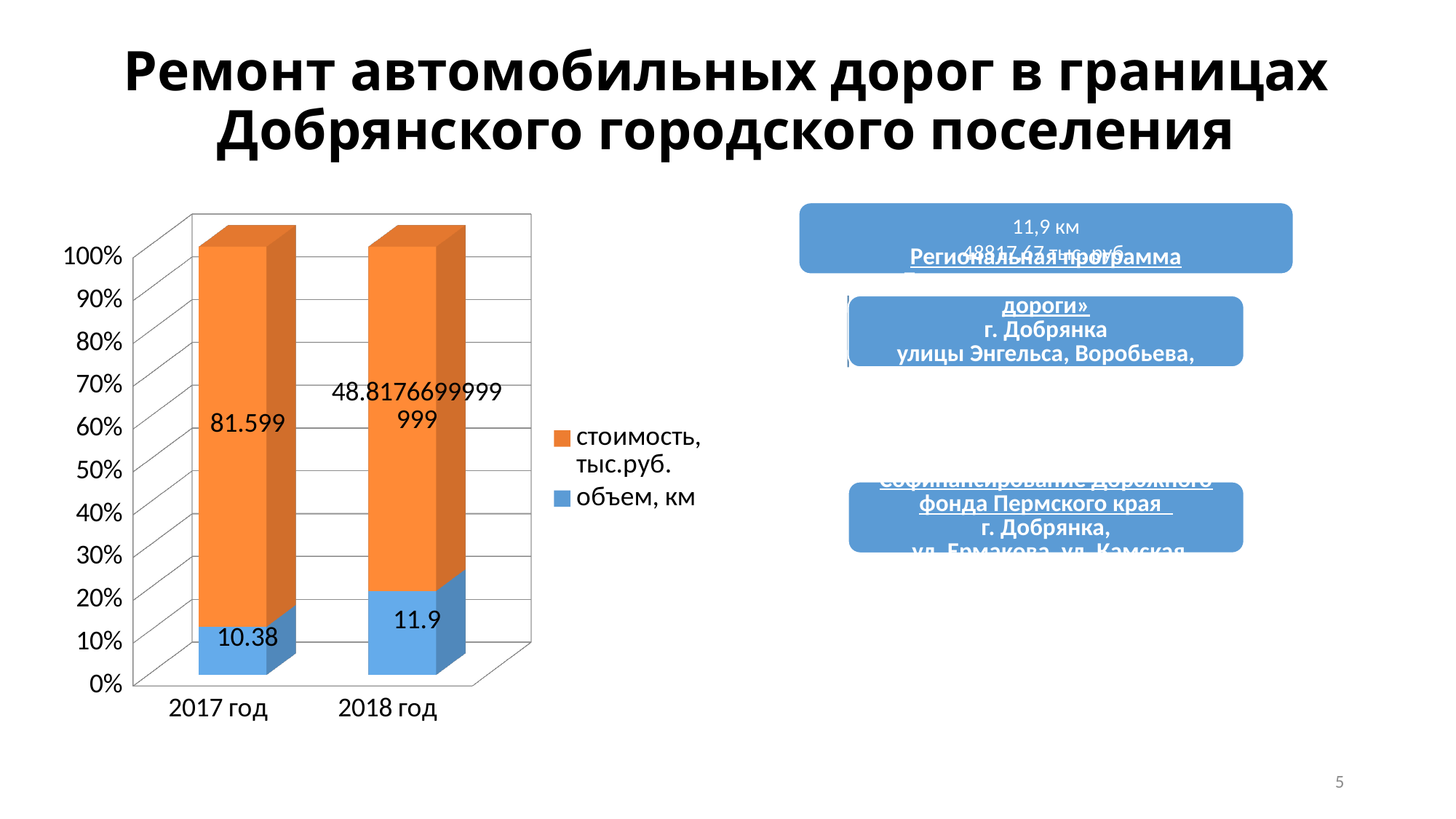
What kind of chart is shown on the slide? Stacked bar chart What is the value of объем, км for 2017 год? 10.38 Is the share of the стоимость, тыс.руб. segment in the 2017 год bar greater or less than 80%? greater What is the value of стоимость, тыс.руб. for 2017 год? 81.599 How many series does the chart legend list? 2 How many years (categories) are shown on the x axis of the chart? 2 Which year has the lower value of стоимость, тыс.руб.? 2018 год What is the value of объем, км for 2018 год? 11.9 What is the difference in объем, км between 2018 год and 2017 год? 1.52 Is стоимость, тыс.руб. larger in 2017 год or 2018 год? 2017 год What is the value of стоимость, тыс.руб. for 2018 год? 48.8176699999999 Which year has the higher value of объем, км? 2018 год